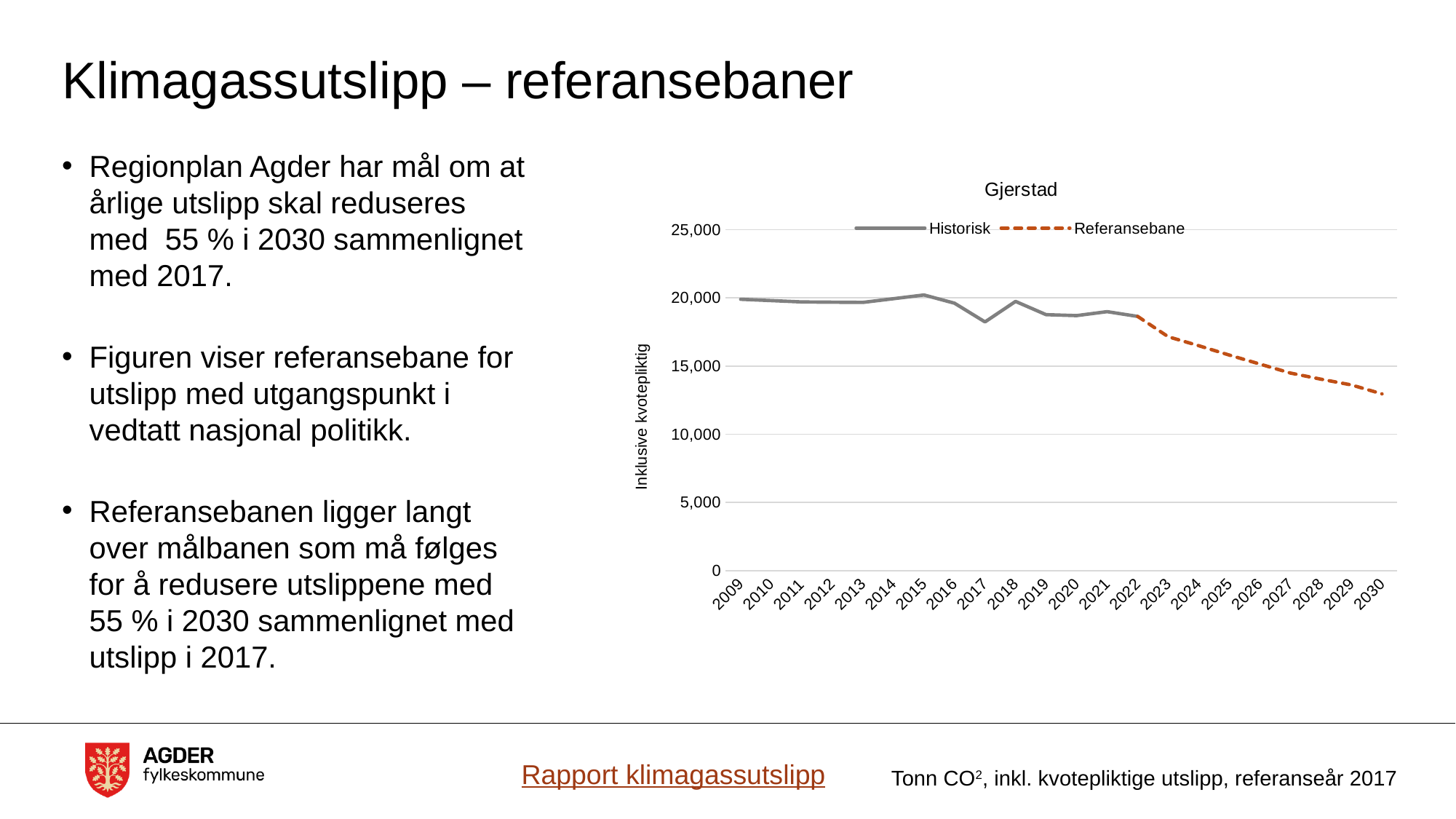
Does the Referansebane series rise or fall from 2022 to 2030? Fall How many years are shown on the x axis of the chart? 22 Which year has the lowest value in the chart? 2030 What kind of chart is shown on the slide? Line chart Is the value for 2017 greater or less than 20,000? less Is the value for 2030 greater or less than 10,000? greater What are the names of the two series in the chart legend? Historisk and Referansebane How many series does the chart legend list? 2 Which is larger, the value for 2022 or the value for 2030? 2022 What is the title of the chart? Gjerstad Is the value for 2030 greater or less than 15,000? less Which is larger, the value for 2017 or the value for 2018? 2018